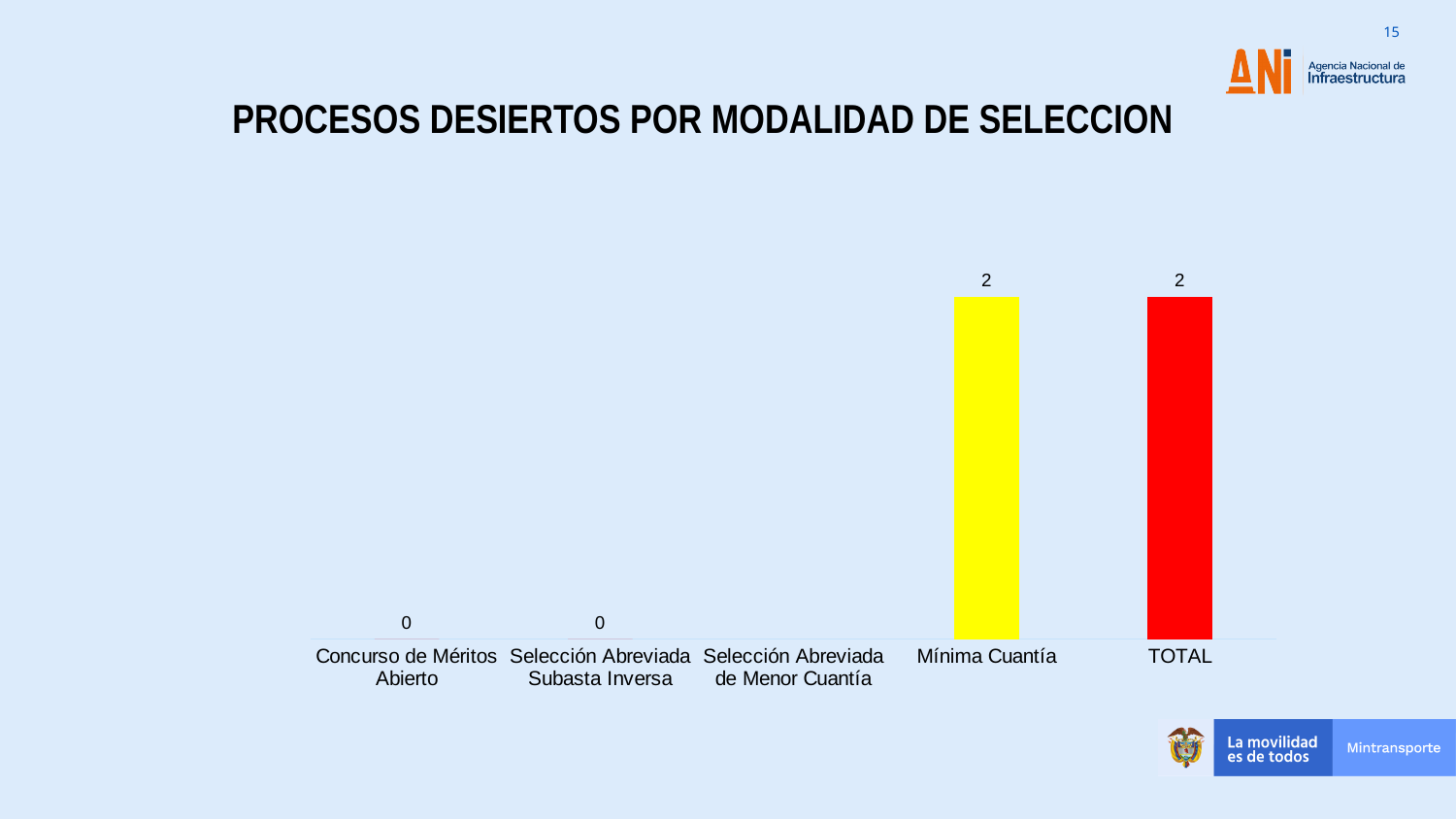
What is the value for TOTAL? 2 What is the difference between the value for Mínima Cuantía and the value for Selección Abreviada Subasta Inversa? 2 How many categories are shown on the x axis of the chart? 5 What colour is the TOTAL bar? Red What is the value for Mínima Cuantía? 2 What is the title of the chart? PROCESOS DESIERTOS POR MODALIDAD DE SELECCION Excluding the TOTAL bar, which selection modality has the highest value? Mínima Cuantía What kind of chart is shown on the slide? Bar chart What is the value for Concurso de Méritos Abierto? 0 What is the value for Selección Abreviada Subasta Inversa? 0 Which is larger, the value for Mínima Cuantía or the value for Concurso de Méritos Abierto? Mínima Cuantía